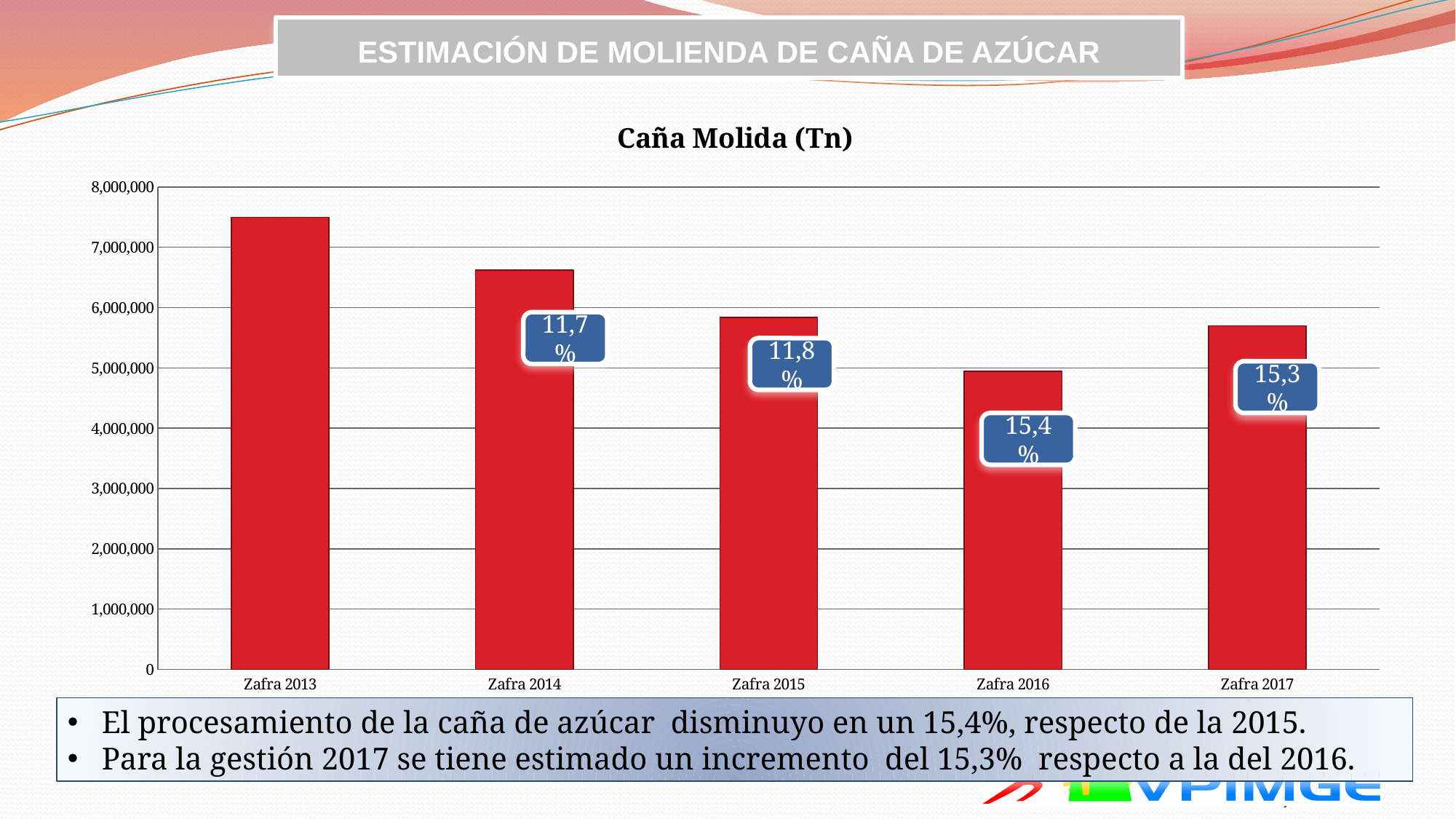
Is the value for Zafra 2016 greater or less than 4,000,000? greater Is the value for Zafra 2015 greater or less than 6,000,000? less Which zafra has the highest value of caña molida? Zafra 2013 Which zafra has the lowest value of caña molida? Zafra 2016 What percentage label is shown next to the Zafra 2016 bar? 15,4% How many bars (zafras) are shown in the chart? 5 Which is larger, the value for Zafra 2014 or Zafra 2017? Zafra 2014 Is the value for Zafra 2013 greater or less than 7,000,000? greater What type of chart is shown on the slide? bar chart Do the values rise or fall from Zafra 2013 to Zafra 2016? fall What is the title of the chart? Caña Molida (Tn)